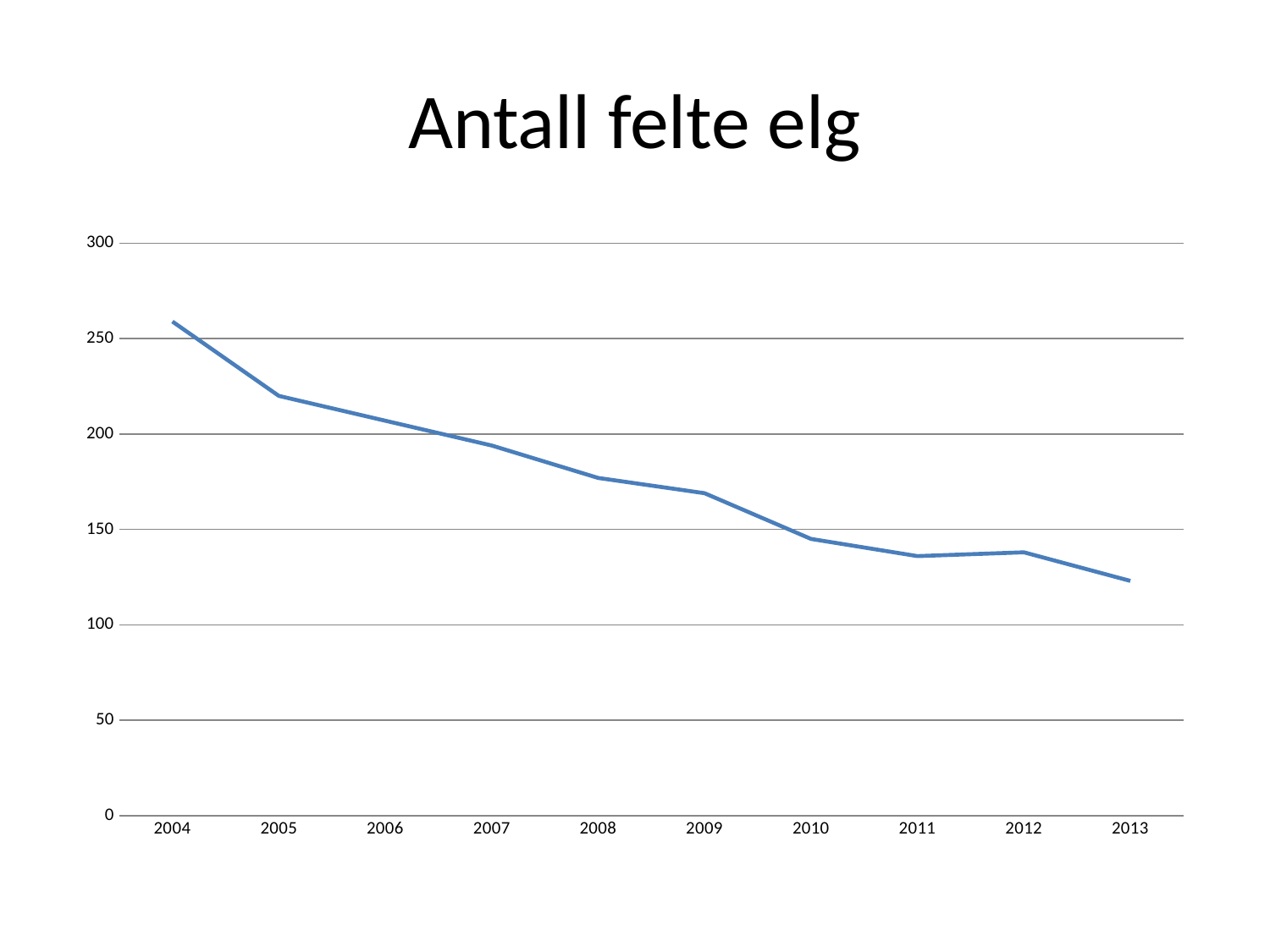
Is the value for 2008 greater or less than 200? less What kind of chart is shown on the slide? line chart Is the value for 2004 greater or less than 250? greater How many years are plotted along the x axis? 10 Is the value for 2013 greater or less than 150? less Which year has the highest value? 2004 What is the title of the chart? Antall felte elg Do the values generally rise or fall from 2004 to 2013? fall Which year has the lowest value? 2013 Which year has the larger value, 2009 or 2013? 2009 Which year has the larger value, 2005 or 2010? 2005